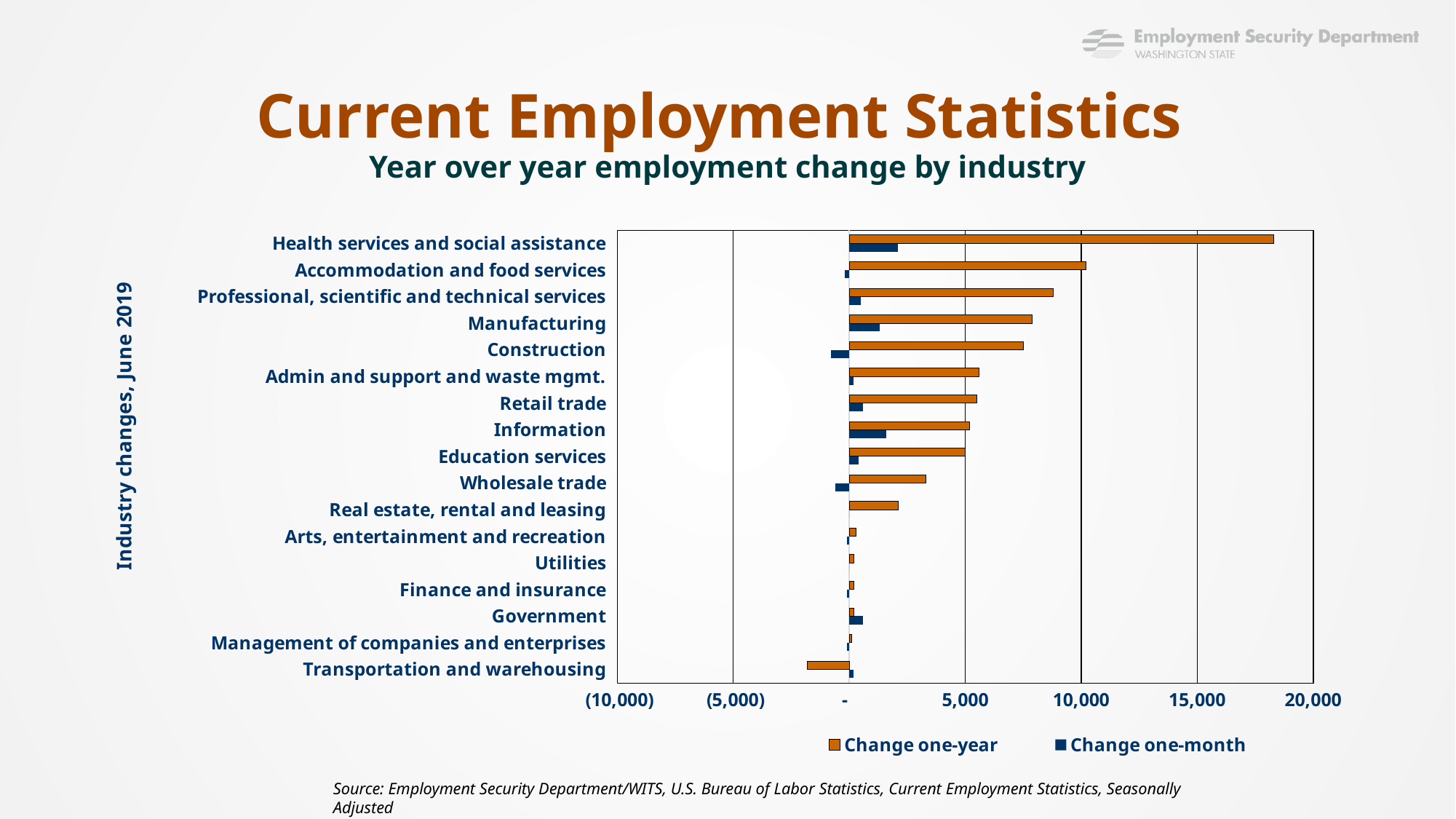
What kind of chart is shown on the slide? bar chart Which industry has the largest one-month employment change? Health services and social assistance Is the one-year change for Manufacturing greater or less than 10,000? less How many industries are plotted on the chart? 17 Is the one-year change for Construction greater or less than 5,000? greater Which has the larger one-year change, Wholesale trade or Real estate, rental and leasing? Wholesale trade Which industry has the lowest one-year employment change? Transportation and warehousing Which industry has the highest one-year employment change? Health services and social assistance Is the one-year change for Wholesale trade greater or less than 5,000? less How many series does the legend list? 2 What are the two series named in the legend? Change one-year and Change one-month